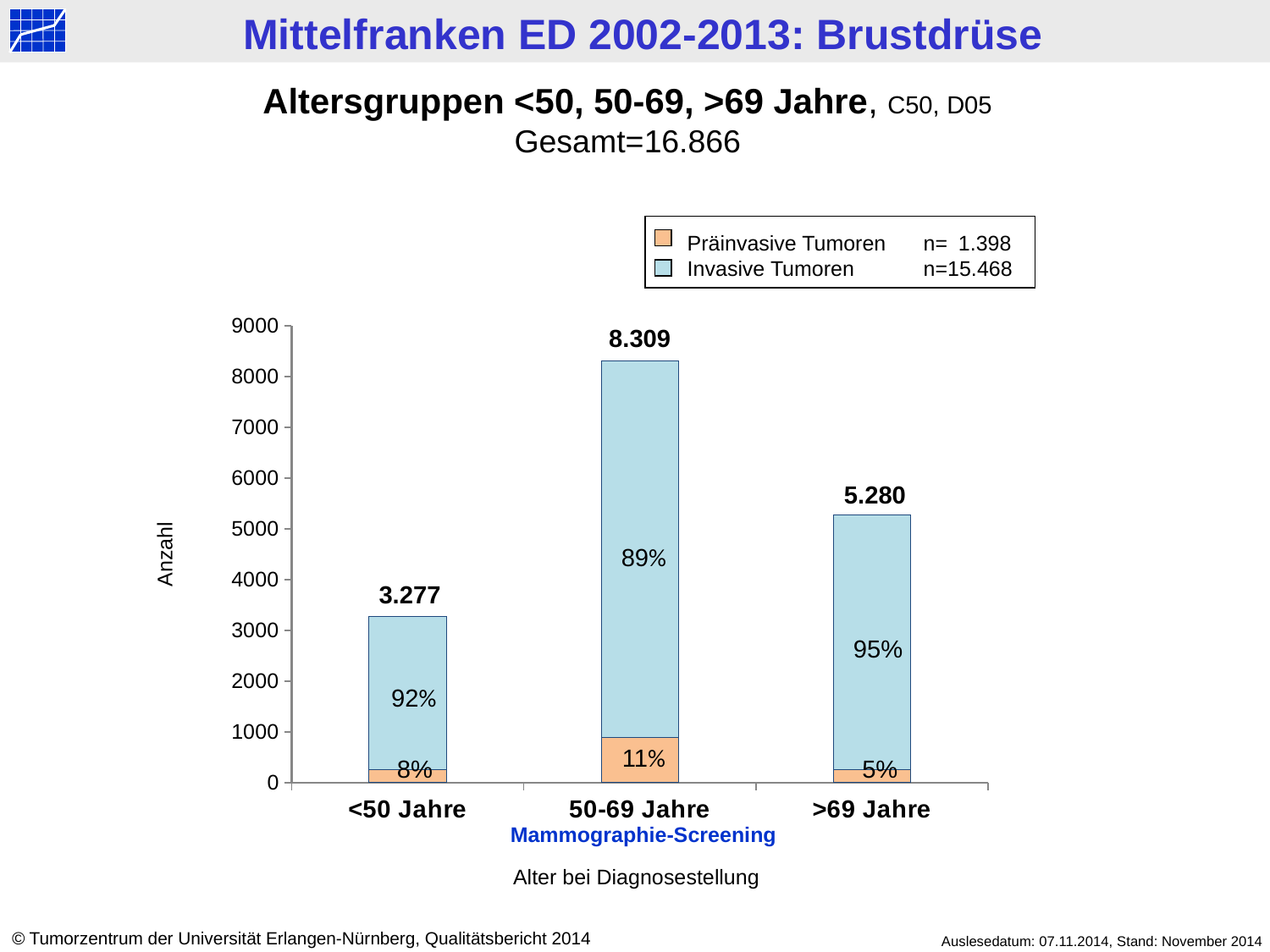
Which is larger, the total for >69 Jahre or the total for <50 Jahre? >69 Jahre What is the difference between the totals for 50-69 Jahre and <50 Jahre? 5.032 According to the legend, what is n for Präinvasive Tumoren? 1.398 How many series does the legend list? 2 Which age group has the lowest total? <50 Jahre What percentage of the 50-69 Jahre bar is Präinvasive Tumoren? 11% What percentage of the >69 Jahre bar is Invasive Tumoren? 95% What is the total number shown above the bar for <50 Jahre? 3.277 What is the total number shown above the bar for 50-69 Jahre? 8.309 How many age groups are shown on the x axis? 3 Which age group has the highest total? 50-69 Jahre What kind of chart is shown on the slide? Stacked bar chart